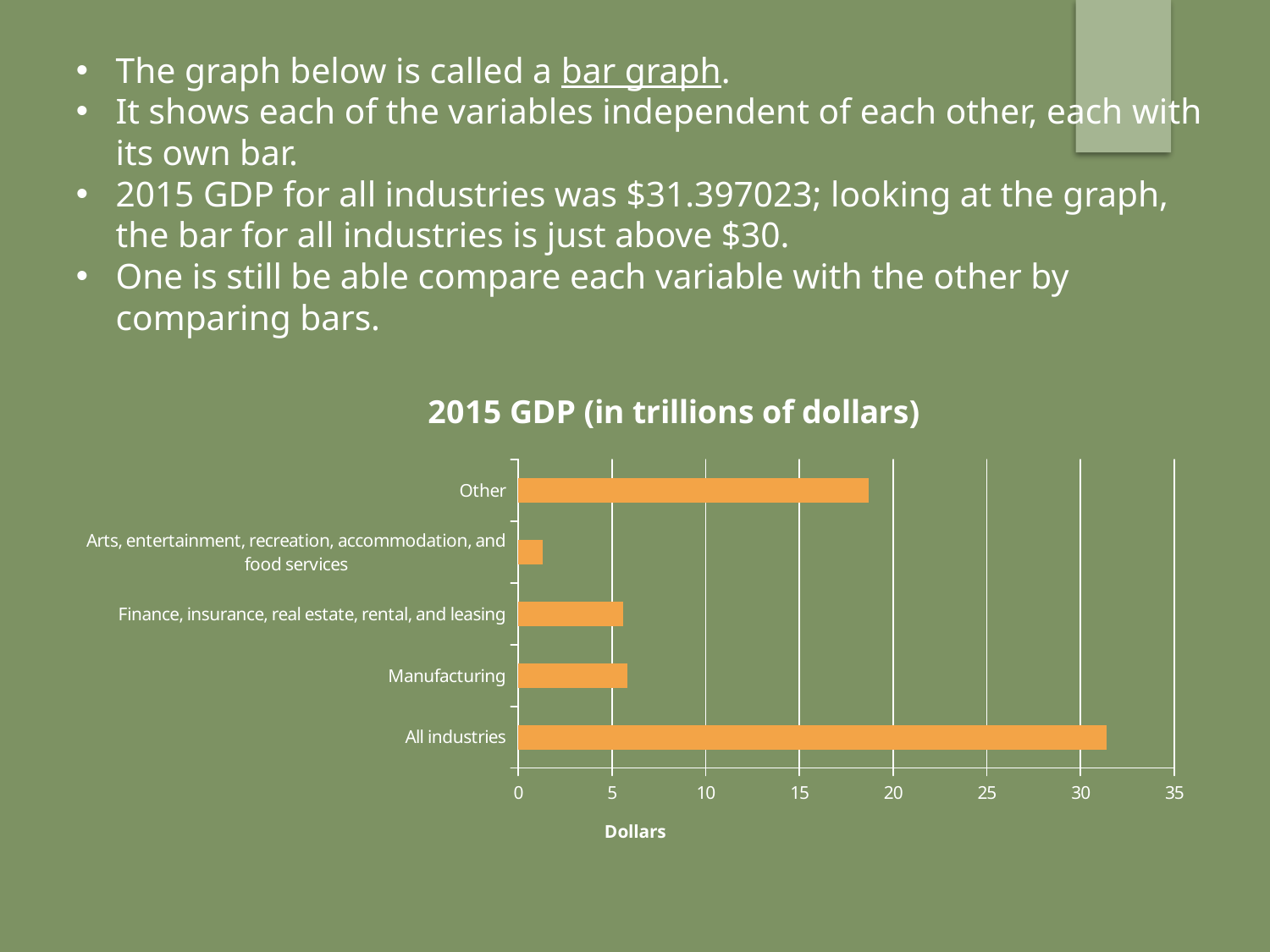
What kind of chart is shown on the slide? bar chart What is the title of the chart? 2015 GDP (in trillions of dollars) Is the value for Other greater or less than 15? greater Which is larger, the value for Other or the value for Manufacturing? Other What is the label on the horizontal axis of the chart? Dollars Is the value for Arts, entertainment, recreation, accommodation, and food services greater or less than 5? less Is the value for Finance, insurance, real estate, rental, and leasing greater or less than 10? less Which category has the highest value? All industries How many categories are plotted in the chart? 5 Which category has the lowest value? Arts, entertainment, recreation, accommodation, and food services